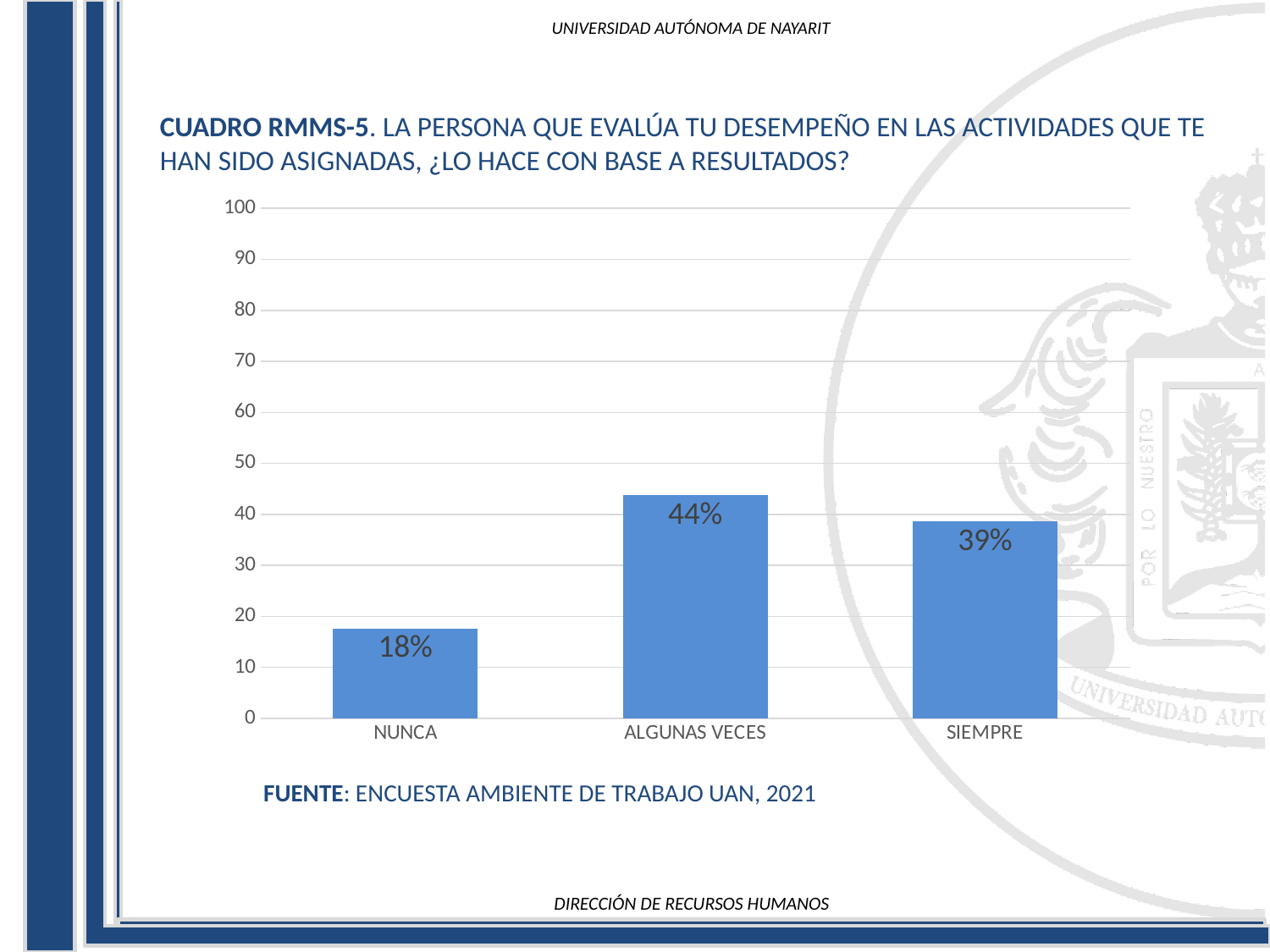
What is the source cited below the chart? ENCUESTA AMBIENTE DE TRABAJO UAN, 2021 What is the difference between the values for ALGUNAS VECES and SIEMPRE? 5% What is the value for NUNCA? 18% Is the value for ALGUNAS VECES greater or less than 50? less What is the difference between the values for SIEMPRE and NUNCA? 21% Which category has the lowest value? NUNCA Which category has the highest value? ALGUNAS VECES What is the value for SIEMPRE? 39% How many categories are shown on the x axis? 3 What is the value for ALGUNAS VECES? 44% Which is larger, the value for NUNCA or the value for SIEMPRE? SIEMPRE What kind of chart is shown on the slide? bar chart